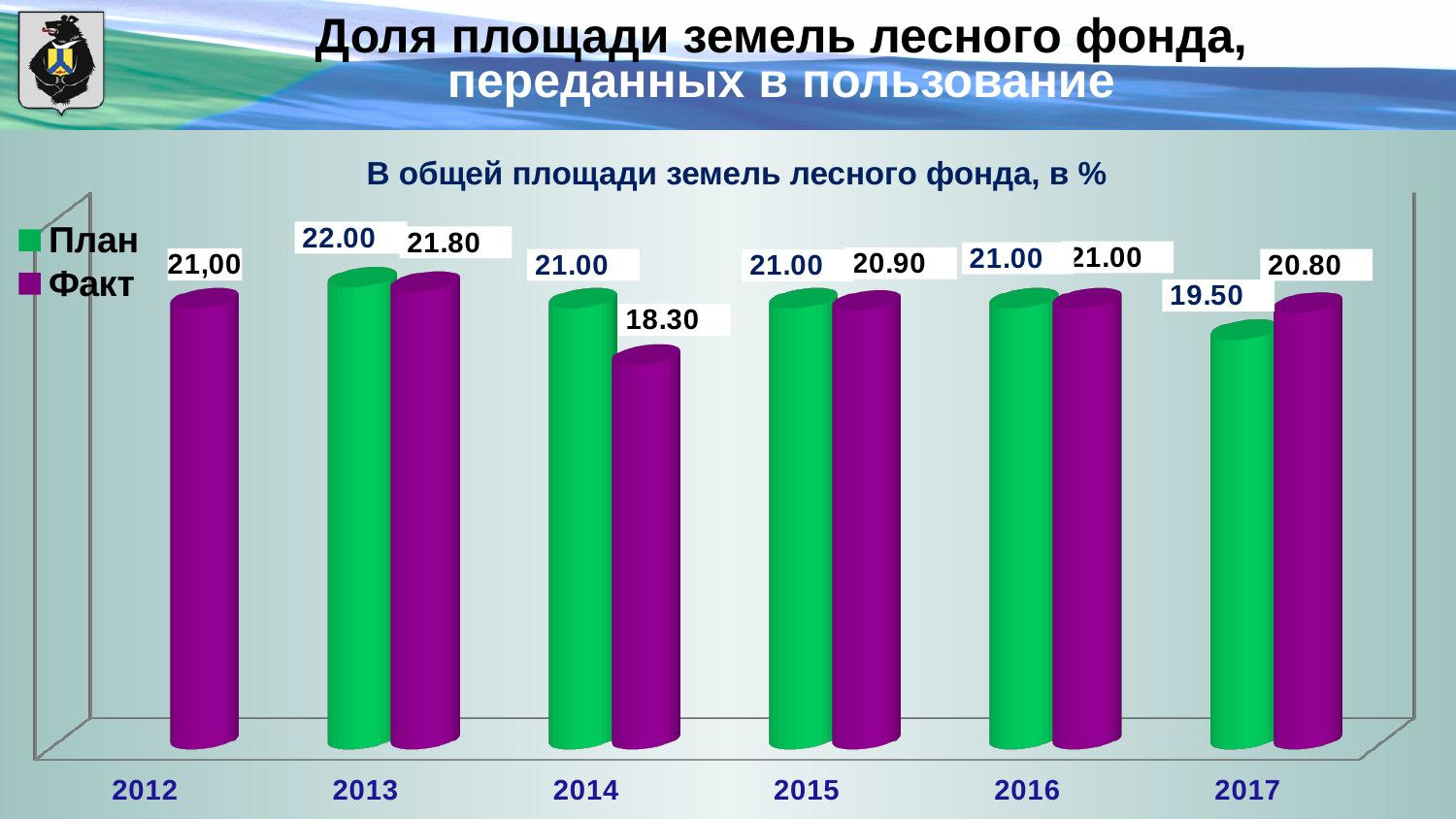
In which year is the План value the lowest? 2017 Which is larger in 2017, План or Факт? Факт In which year is the Факт value the lowest? 2014 In which year is the Факт value the highest? 2013 What is the План value for 2017? 19.50 What kind of chart is shown on the slide? Bar chart What is the difference between the План and Факт values in 2014? 2.70 What is the Факт value for 2014? 18.30 How many years are shown on the x axis? 6 What is the Факт value for 2012? 21,00 What is the План value for 2013? 22.00 How many series does the legend list? 2